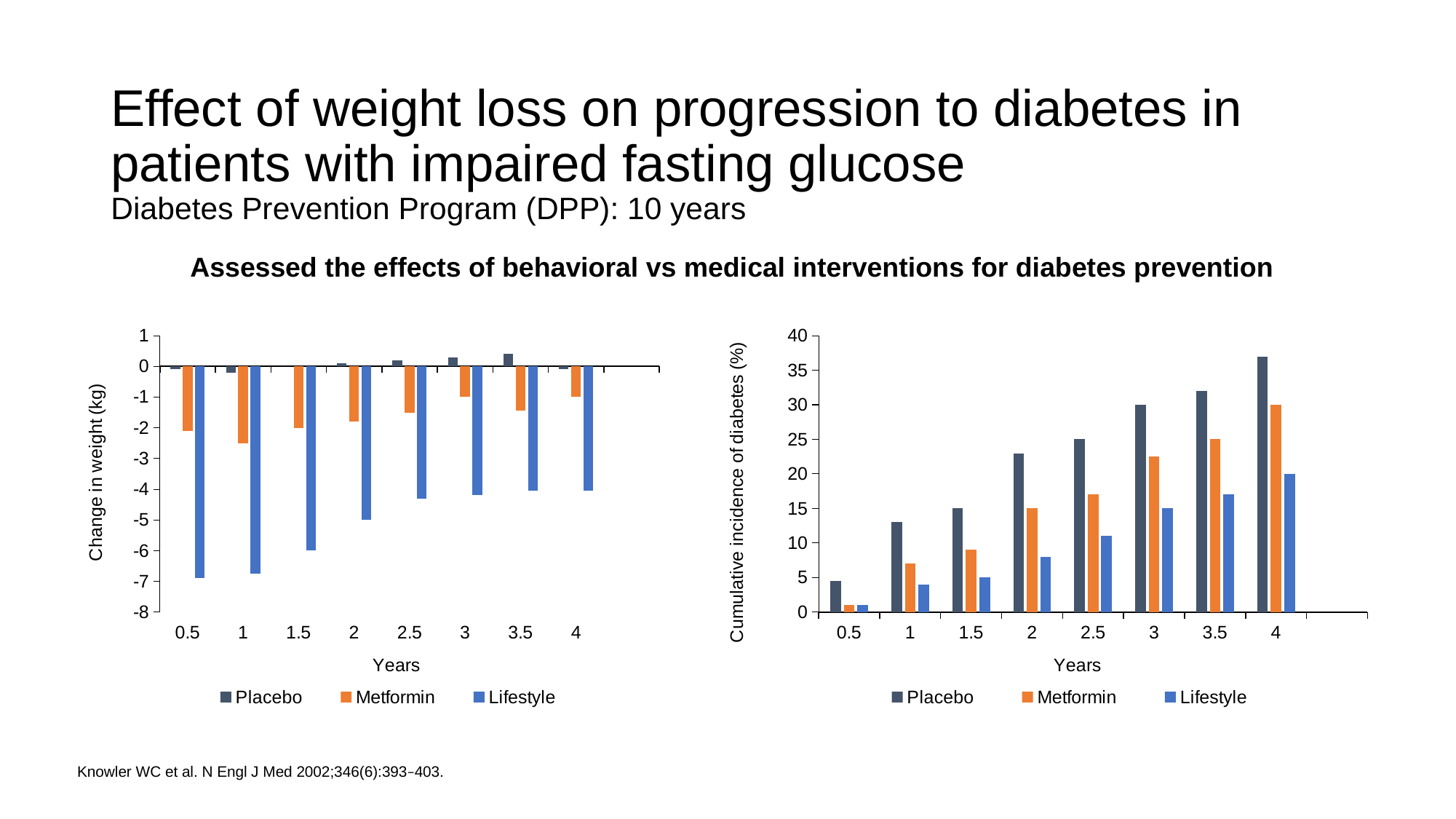
In the right-hand chart (Cumulative incidence of diabetes), which series has the highest value at year 4? Placebo In the left-hand chart (Change in weight), how many series does the legend list? 3 What kind of chart is the right-hand chart (Cumulative incidence of diabetes)? bar chart In the right-hand chart (Cumulative incidence of diabetes), which is larger at year 3: Metformin or Lifestyle? Metformin In the left-hand chart (Change in weight), is the Lifestyle value at year 0.5 greater or less than -6? less In the left-hand chart (Change in weight), which series shows the lowest value (greatest weight loss) at year 0.5? Lifestyle In the right-hand chart (Cumulative incidence of diabetes), how many time points are shown on the x axis? 8 In the left-hand chart (Change in weight), is the Metformin value at year 1 greater or less than -2? less In the right-hand chart (Cumulative incidence of diabetes), does the Placebo series rise or fall from year 0.5 to year 4? rises What is the y-axis label of the left-hand chart? Change in weight (kg) In the right-hand chart (Cumulative incidence of diabetes), is the Placebo value at year 4 greater or less than 35? greater